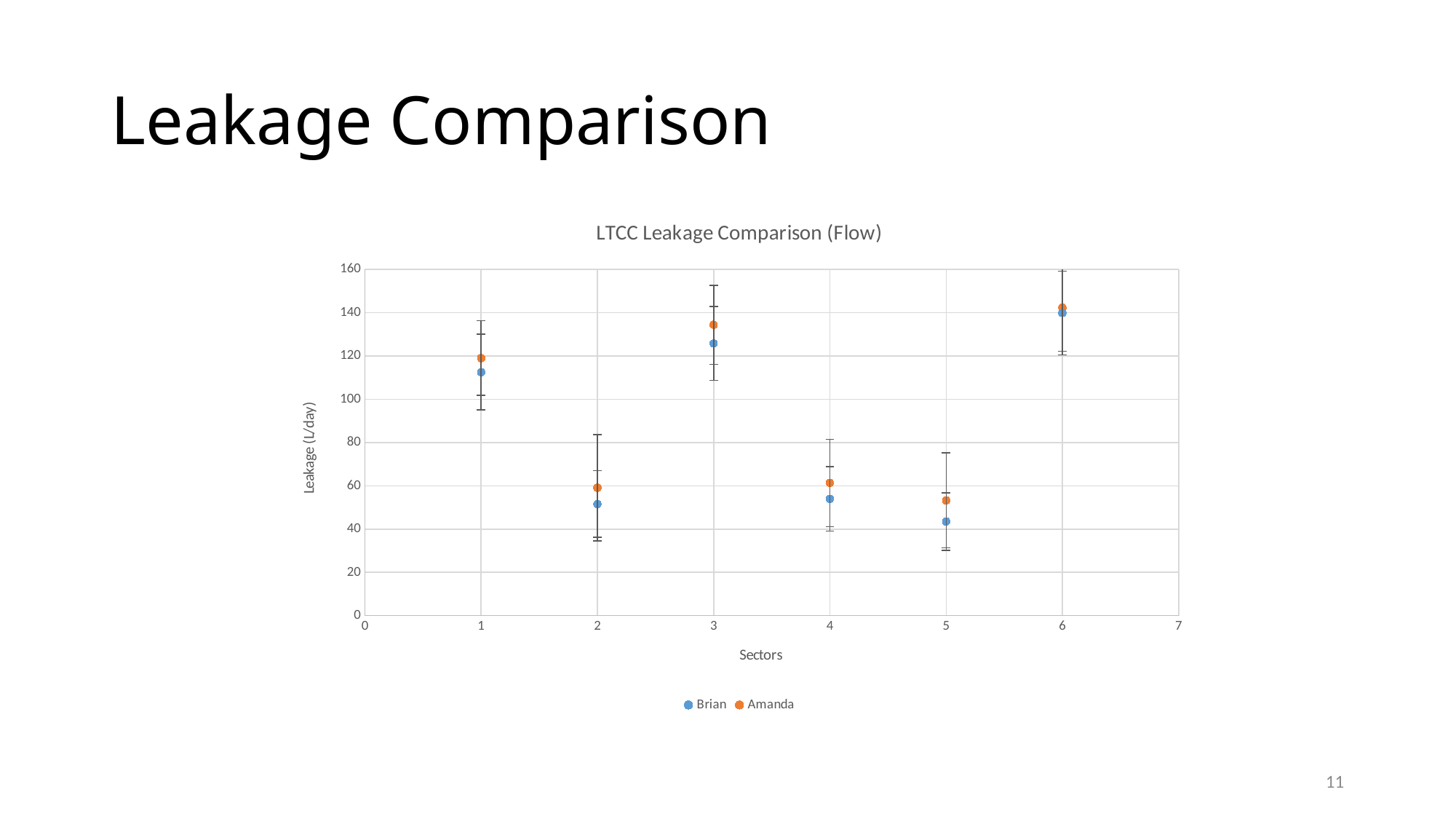
How many sectors have data points plotted? 6 At sector 3, which series has the larger value, Brian or Amanda? Amanda Is the value for Brian at sector 5 greater or less than 60? less Is the value for Brian at sector 1 greater or less than 100? greater Is the value for Amanda at sector 3 greater or less than 120? greater What is the label of the vertical axis? Leakage (L/day) What kind of chart is shown on the slide? Scatter chart For which sector is Brian's leakage value lowest? 5 What is the title of the chart? LTCC Leakage Comparison (Flow) For which sector is Brian's leakage value highest? 6 How many series does the legend list? 2